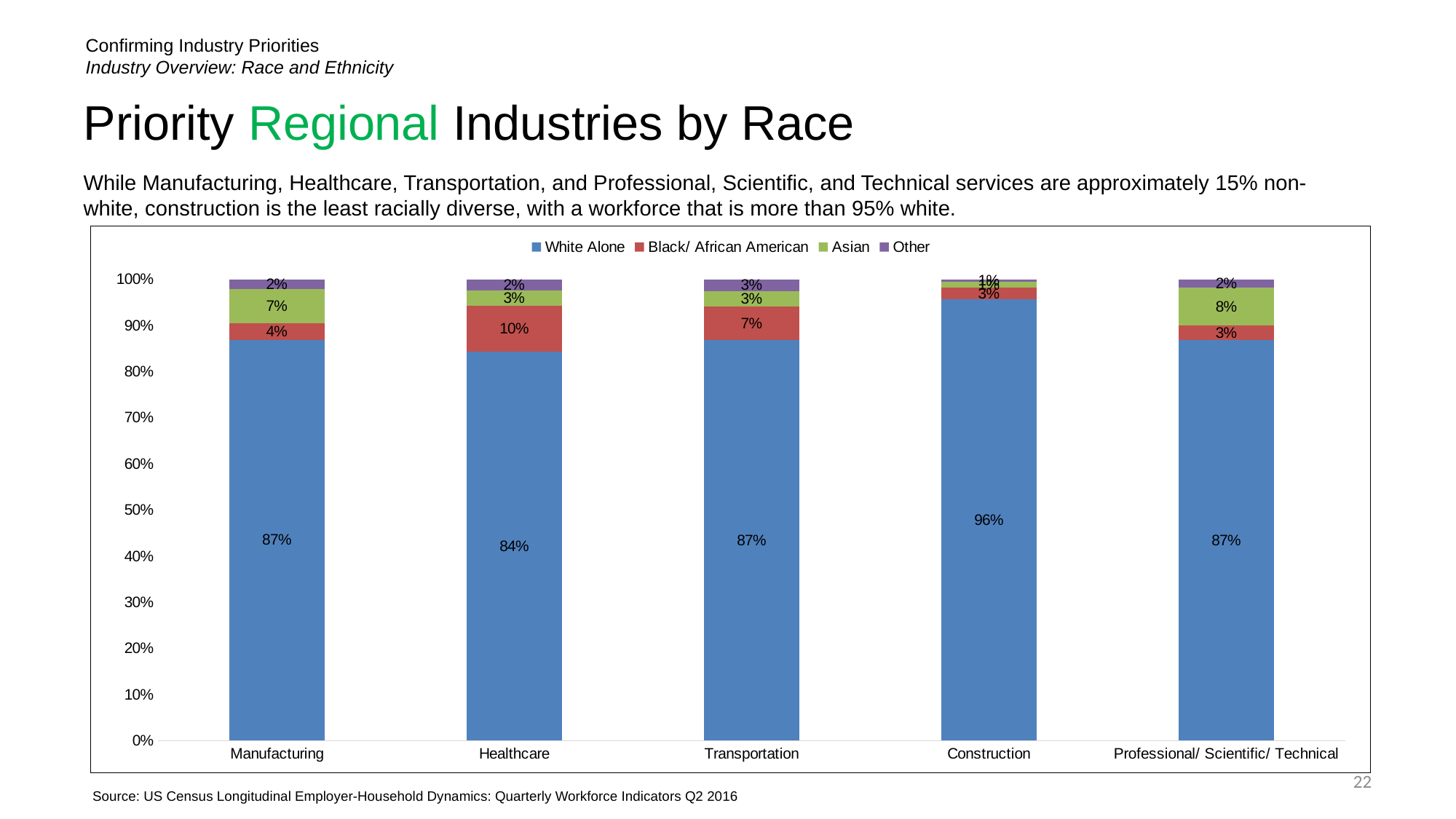
What is the Other share for Transportation? 3% Which colour represents the White Alone series in the chart? Blue What is the difference between the Black/ African American share for Healthcare and for Manufacturing? 6 percentage points What kind of chart is shown on the slide? Stacked bar chart How many industries are shown on the x axis of the chart? 5 Which industry has the lowest White Alone share? Healthcare Which is larger, the Asian share for Manufacturing or the Asian share for Transportation? Manufacturing Which industry has the highest White Alone share? Construction What is the Black/ African American share for Healthcare? 10% What is the White Alone share for Healthcare? 84% How many series does the chart's legend list? 4 What is the Asian share for Professional/ Scientific/ Technical? 8%